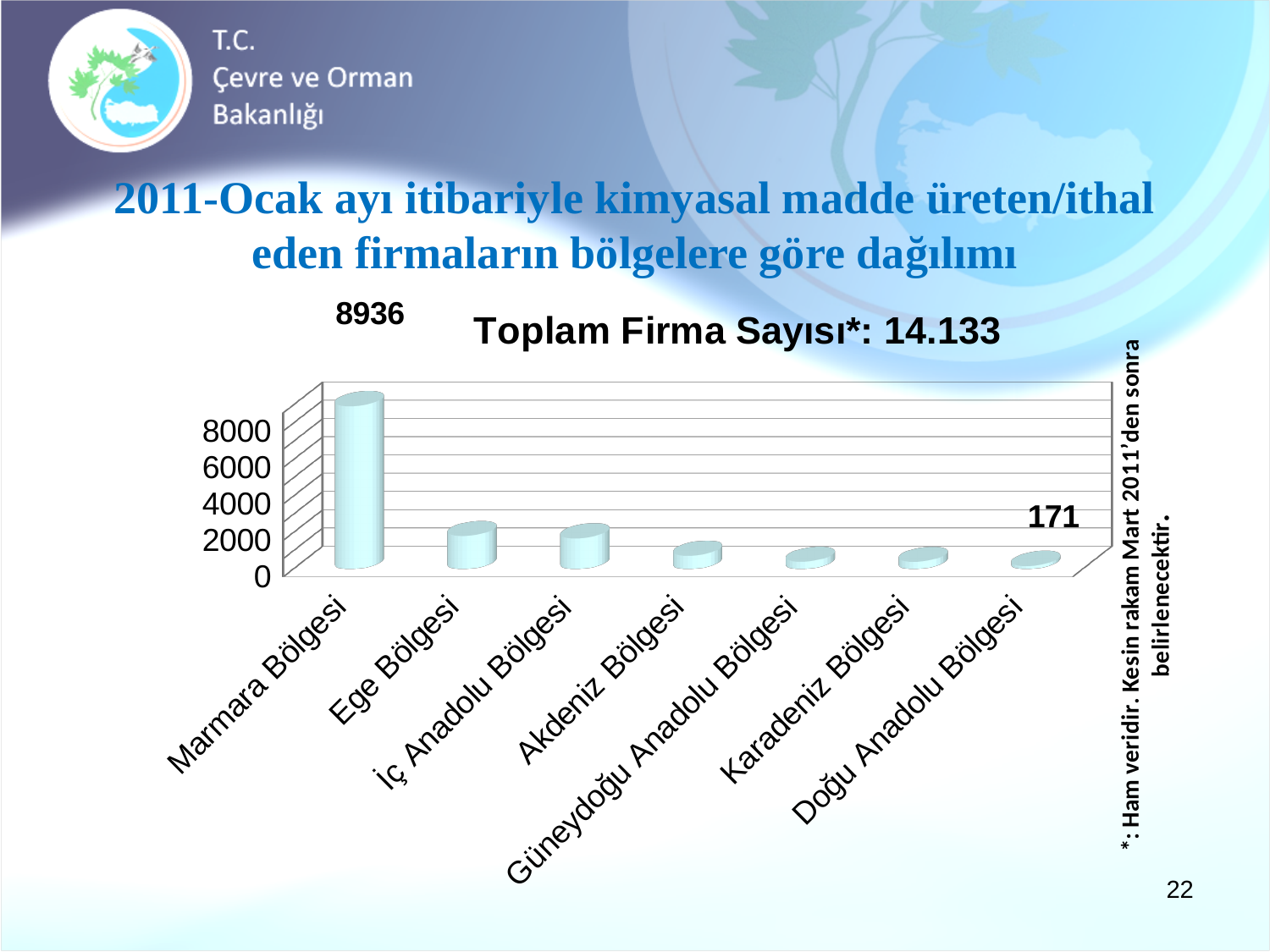
Is the value for Karadeniz Bölgesi greater or less than 2000? less Which is larger, the value for Ege Bölgesi or the value for Akdeniz Bölgesi? Ege Bölgesi Which region has the lowest value? Doğu Anadolu Bölgesi How many regions are shown on the x axis? 7 What is the value for Doğu Anadolu Bölgesi? 171 Is the value for Akdeniz Bölgesi greater or less than 2000? less What is the value for Marmara Bölgesi? 8936 What is the difference between the values for Marmara Bölgesi and Doğu Anadolu Bölgesi? 8765 What kind of chart is shown on the slide? bar chart What is the title of the chart? Toplam Firma Sayısı*: 14.133 Which region has the highest value? Marmara Bölgesi Is the value for Marmara Bölgesi greater or less than 8000? greater